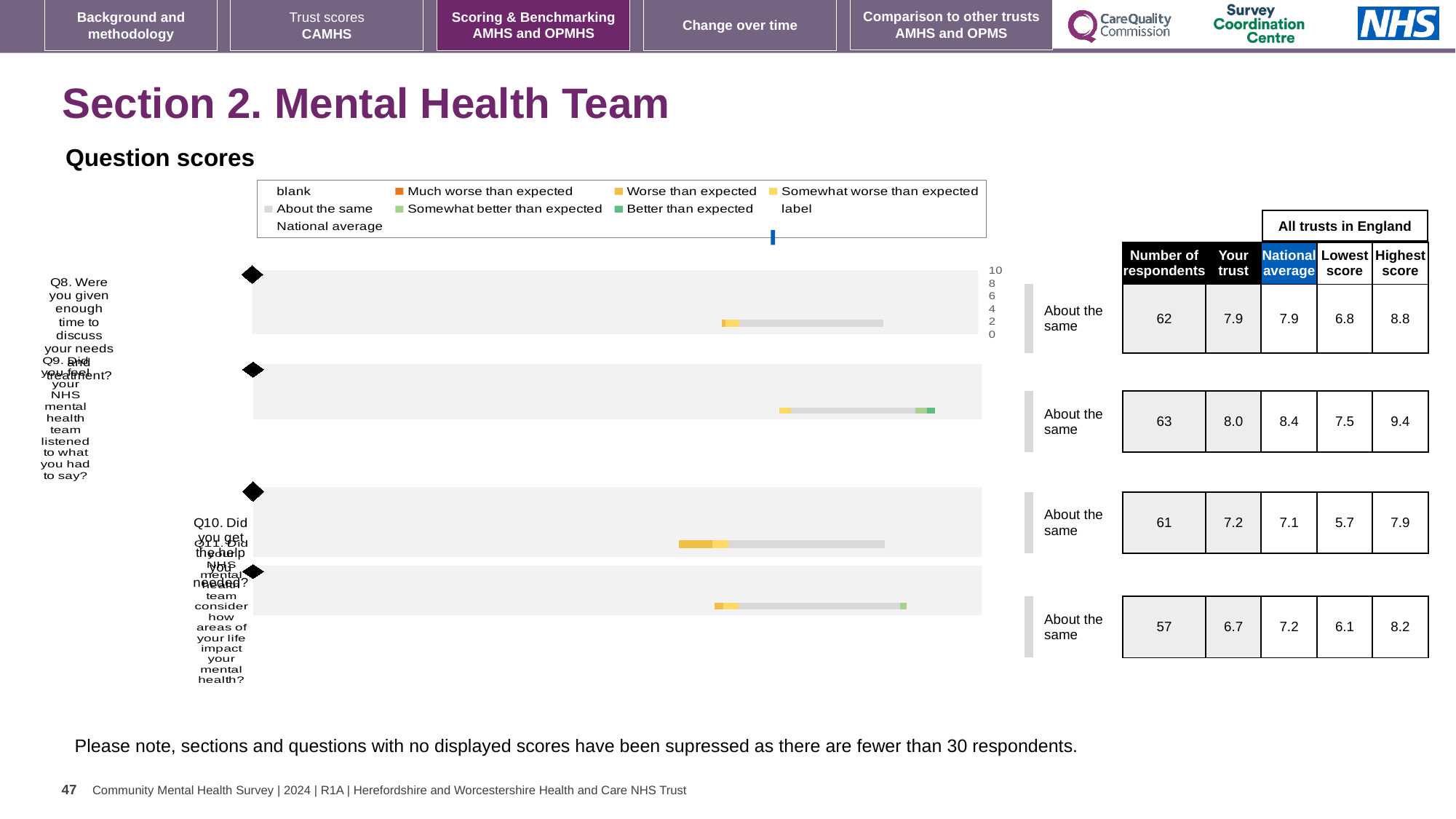
What is the national average score for Q9? 8.4 What is the 'Your trust' score for Q8 (Were you given enough time to discuss your needs and treatment?)? 7.9 What is the lowest score among all trusts in England for Q10 (Did you get the help you needed?)? 5.7 For Q10, which is larger: the 'Your trust' score or the national average? Your trust What kind of chart is used for the question scores? Bar chart How many questions are plotted in the Question scores charts on this slide? 4 What is the difference between the highest score and the lowest score for Q9? 1.9 Which question has the highest 'Your trust' score on this slide? Q9 Which question has the lowest 'Your trust' score on this slide? Q11 For Q11, how much higher is the national average than the 'Your trust' score? 0.5 What benchmark label is shown next to the Q8 chart? About the same How many respondents answered Q11? 57